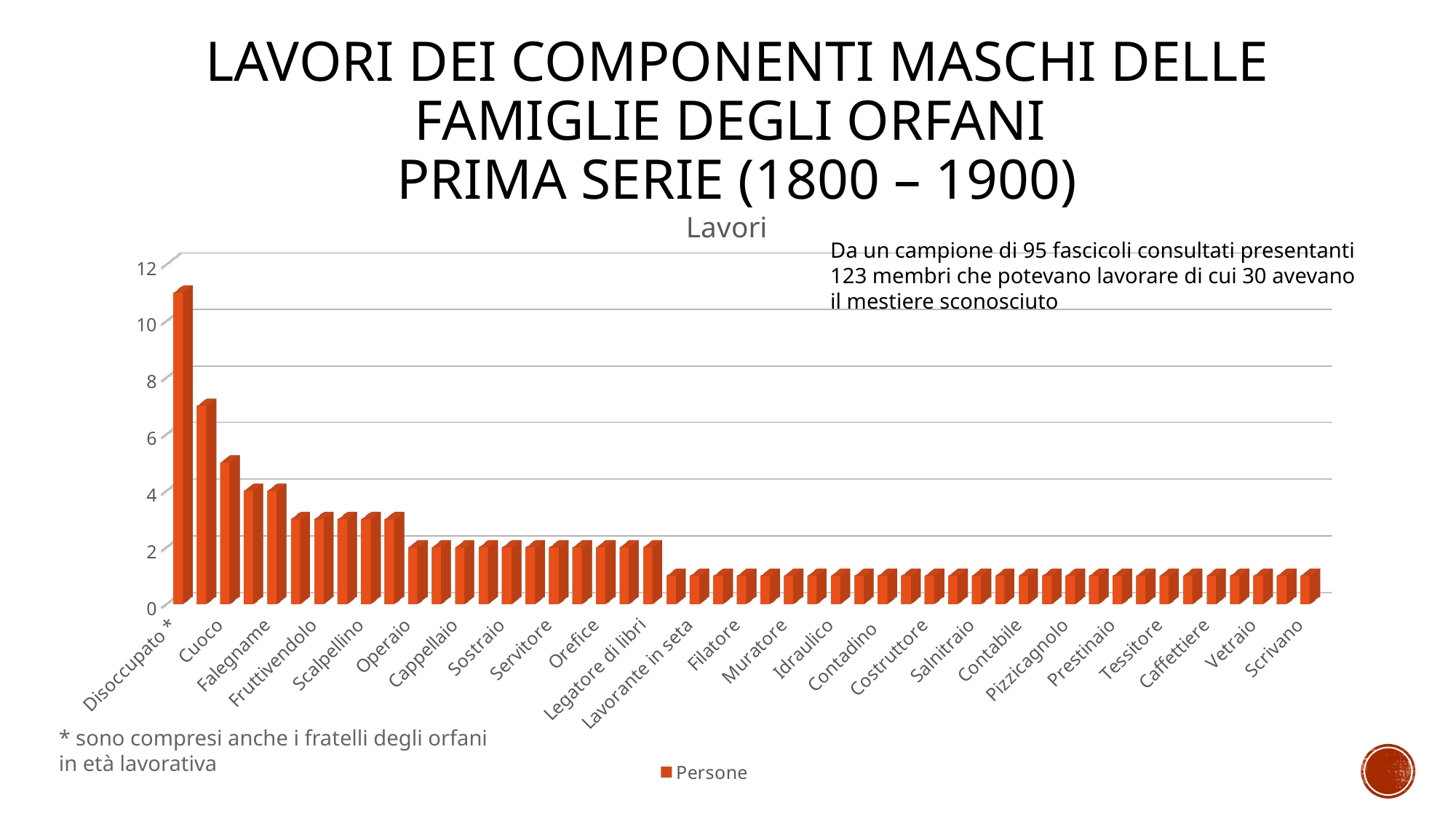
Is the value for Disoccupato * greater or less than 10? greater How many series does the legend list? 1 What is the name of the series shown in the legend? Persone Is the value for Fruttivendolo greater or less than 4? less What kind of chart is shown on the slide? bar chart What is the value for Falegname? 4 Which category has the highest value? Disoccupato * Do the values generally rise or fall from left to right along the x axis? fall What is the value for Operaio? 2 What is the title of the chart? Lavori Which is larger, the value for Disoccupato * or the value for Cuoco? Disoccupato * Is the value for Cuoco greater or less than 6? less